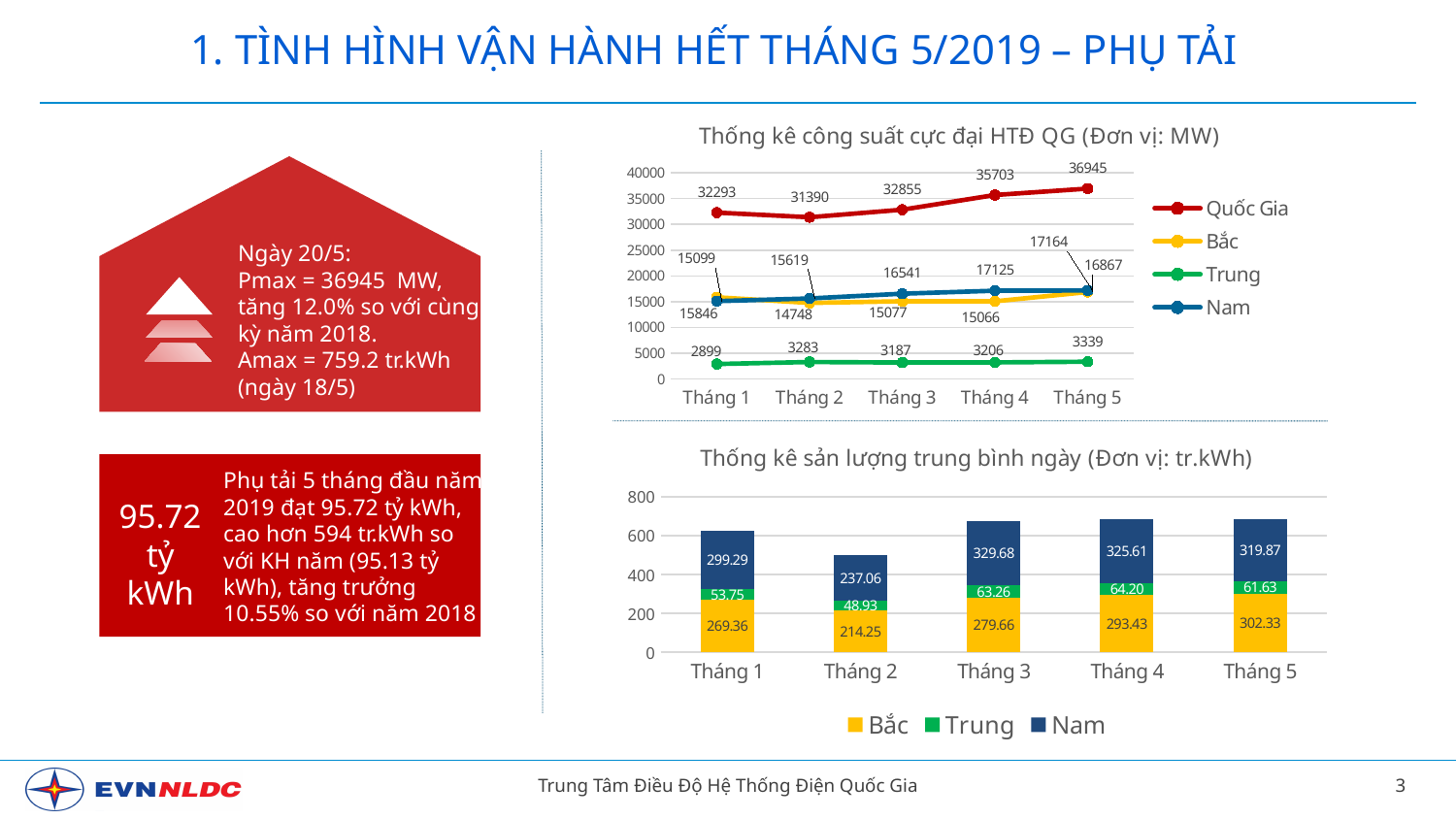
What type of chart is 'Thống kê sản lượng trung bình ngày (Đơn vị: tr.kWh)'? Stacked bar chart What type of chart is 'Thống kê công suất cực đại HTĐ QG (Đơn vị: MW)'? Line chart In the chart 'Thống kê công suất cực đại HTĐ QG (Đơn vị: MW)', what is the value for Quốc Gia in Tháng 5? 36945 In the chart 'Thống kê sản lượng trung bình ngày (Đơn vị: tr.kWh)', which month has the lowest total stacked bar? Tháng 2 In the chart 'Thống kê công suất cực đại HTĐ QG (Đơn vị: MW)', what is the value for Trung in Tháng 1? 2899 In the chart 'Thống kê sản lượng trung bình ngày (Đơn vị: tr.kWh)', which is larger: Trung in Tháng 4 or Trung in Tháng 5? Trung in Tháng 4 In the chart 'Thống kê công suất cực đại HTĐ QG (Đơn vị: MW)', in which month is the Quốc Gia value lowest? Tháng 2 In the chart 'Thống kê sản lượng trung bình ngày (Đơn vị: tr.kWh)', what is the value for Nam in Tháng 3? 329.68 In the chart 'Thống kê công suất cực đại HTĐ QG (Đơn vị: MW)', how many series does the legend list? 4 In the chart 'Thống kê sản lượng trung bình ngày (Đơn vị: tr.kWh)', what is the value for Bắc in Tháng 2? 214.25 In the chart 'Thống kê sản lượng trung bình ngày (Đơn vị: tr.kWh)', what is the total of the stacked bar for Tháng 1? 622.40 In the chart 'Thống kê công suất cực đại HTĐ QG (Đơn vị: MW)', what is the difference between the Quốc Gia values in Tháng 5 and Tháng 4? 1242